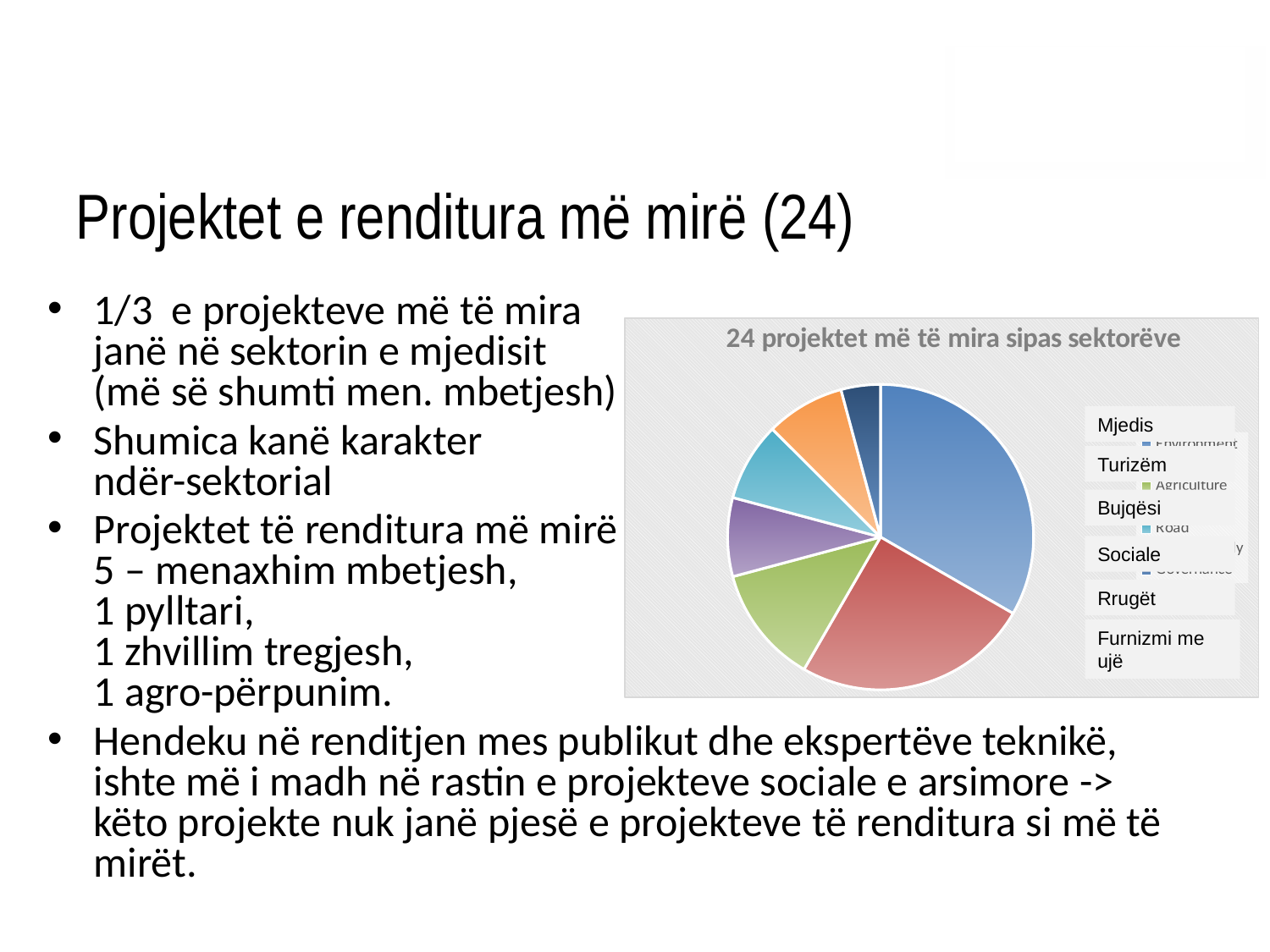
How many slices does the pie chart have? 7 Which slice is larger, the blue slice or the red slice? the blue slice Which slice is larger, the green slice or the purple slice? the green slice What colour is the largest slice of the pie chart? blue Which sector has the largest slice in the pie chart? Mjedis What kind of chart is shown on the slide? pie chart What is the title of the chart? 24 projektet më të mira sipas sektorëve